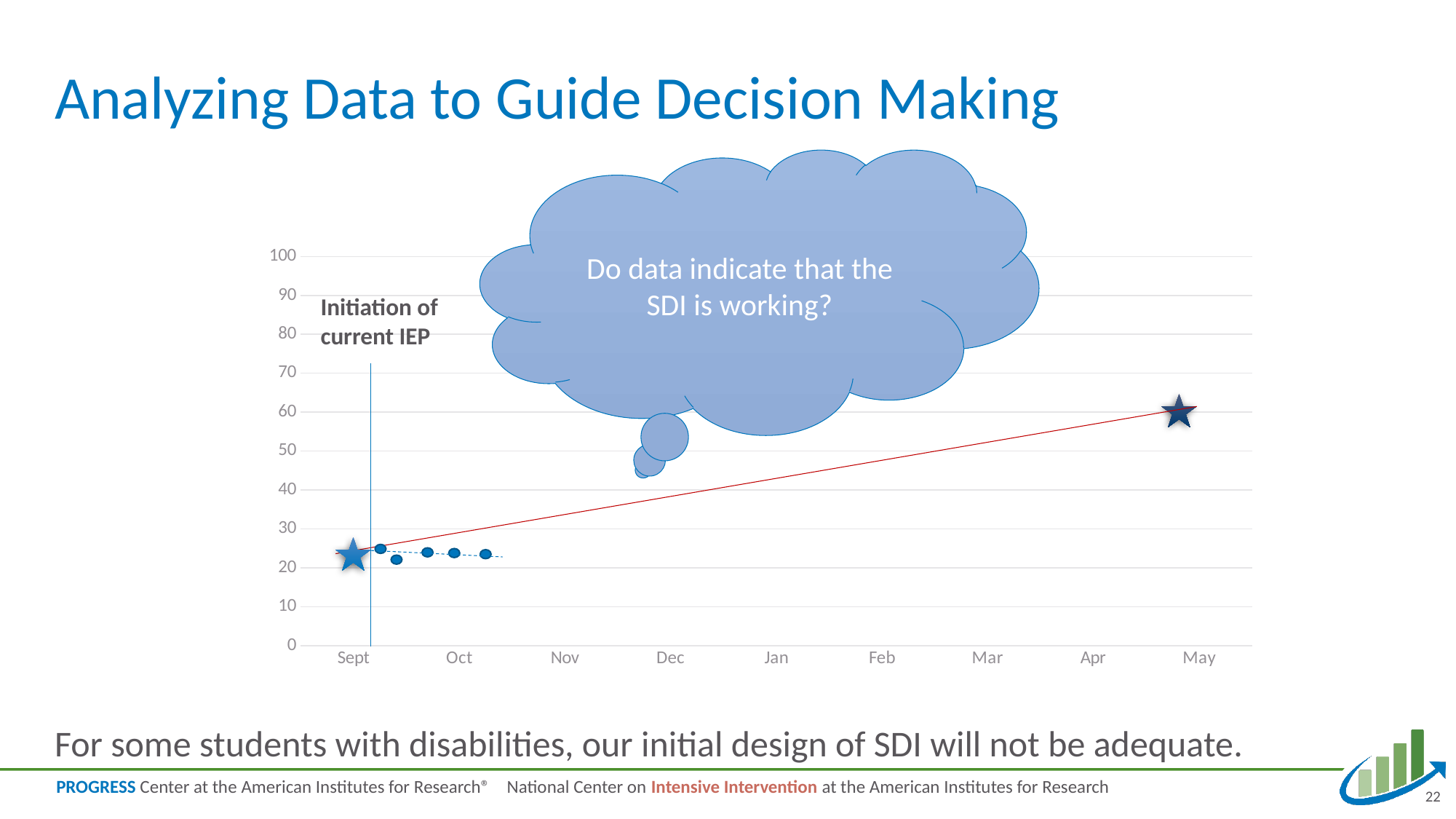
What question is written in the thought bubble above the chart? Do data indicate that the SDI is working? What is the last month labeled on the x axis of the chart? May Is the value of the star marker at May greater or less than 50? greater Is the value of the star marker at Sept greater or less than 30? less What does the label next to the vertical line near Sept say? Initiation of current IEP What is the highest value shown on the y axis of the chart? 100 Are the blue data points plotted between Sept and Oct greater or less than 30? less Does the red line rise or fall from Sept to May? rises What kind of chart is shown on the slide? line chart What is the first month labeled on the x axis of the chart? Sept Which star marker has the higher value, the one at Sept or the one at May? May How many months are labeled along the x axis of the chart? 9